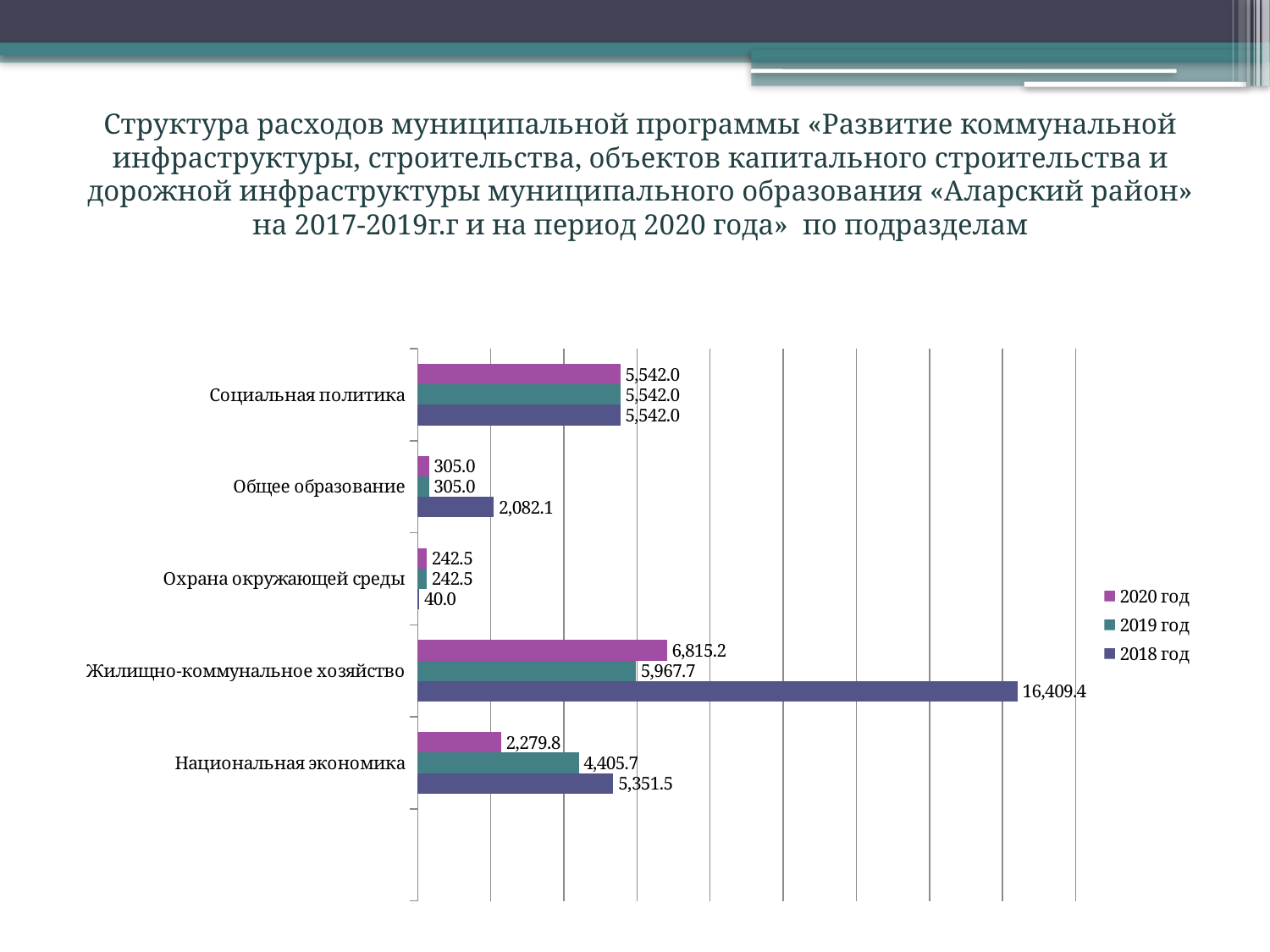
What is the value for Жилищно-коммунальное хозяйство in 2018 год? 16,409.4 What kind of chart is shown on the slide? Bar chart What is the value for Национальная экономика in 2020 год? 2,279.8 What is the value for Общее образование in 2018 год? 2,082.1 Which is larger for Национальная экономика: the 2019 год value or the 2020 год value? 2019 год Which category has the lowest value in the 2020 год series? Охрана окружающей среды What is the difference between the 2018 год and 2019 год values for Жилищно-коммунальное хозяйство? 10,441.7 How many series does the legend list? 3 How many categories are shown on the chart? 5 Which category has the highest value in the 2018 год series? Жилищно-коммунальное хозяйство Which series is shown in purple in the legend? 2020 год What is the value for Охрана окружающей среды in 2019 год? 242.5